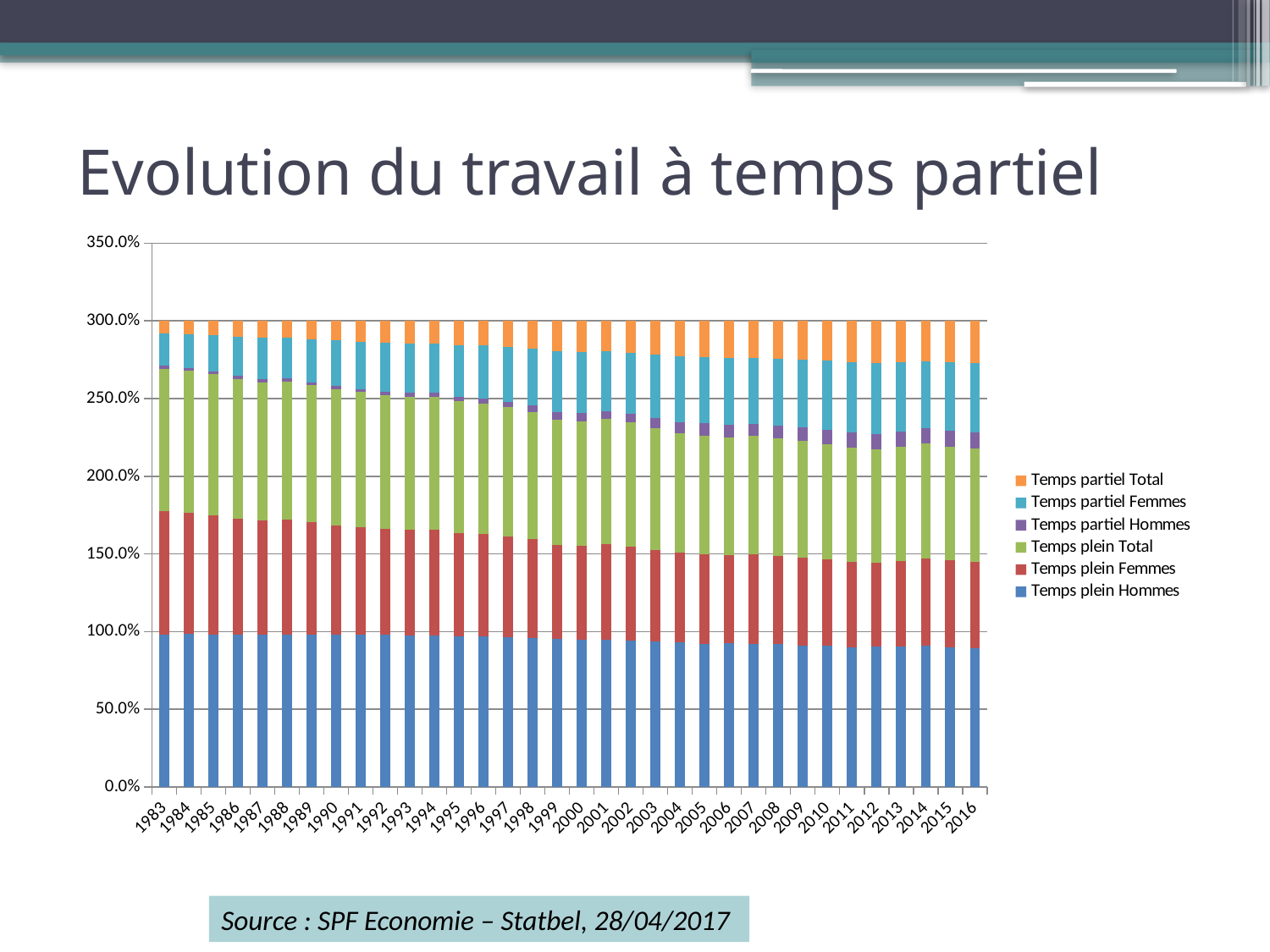
What is the title of the chart? Evolution du travail à temps partiel Is the top of the stacked bar for 2016 greater or less than 250%? greater Does the Temps plein Hommes segment rise or fall from 1983 to 2016? fall How many series does the legend list? 6 Is the Temps plein Hommes segment larger in 1983 or in 2016? 1983 Is the value for Temps plein Hommes in 2016 greater or less than 100%? less Does the Temps partiel Femmes segment rise or fall from 1983 to 2016? rise Is the value for Temps plein Hommes in 1983 greater or less than 50%? greater What is the highest value shown on the y axis? 350.0% What kind of chart is shown on the slide? Stacked bar chart How many years are shown along the x axis? 34 Is the Temps partiel Femmes segment larger in 1983 or in 2016? 2016